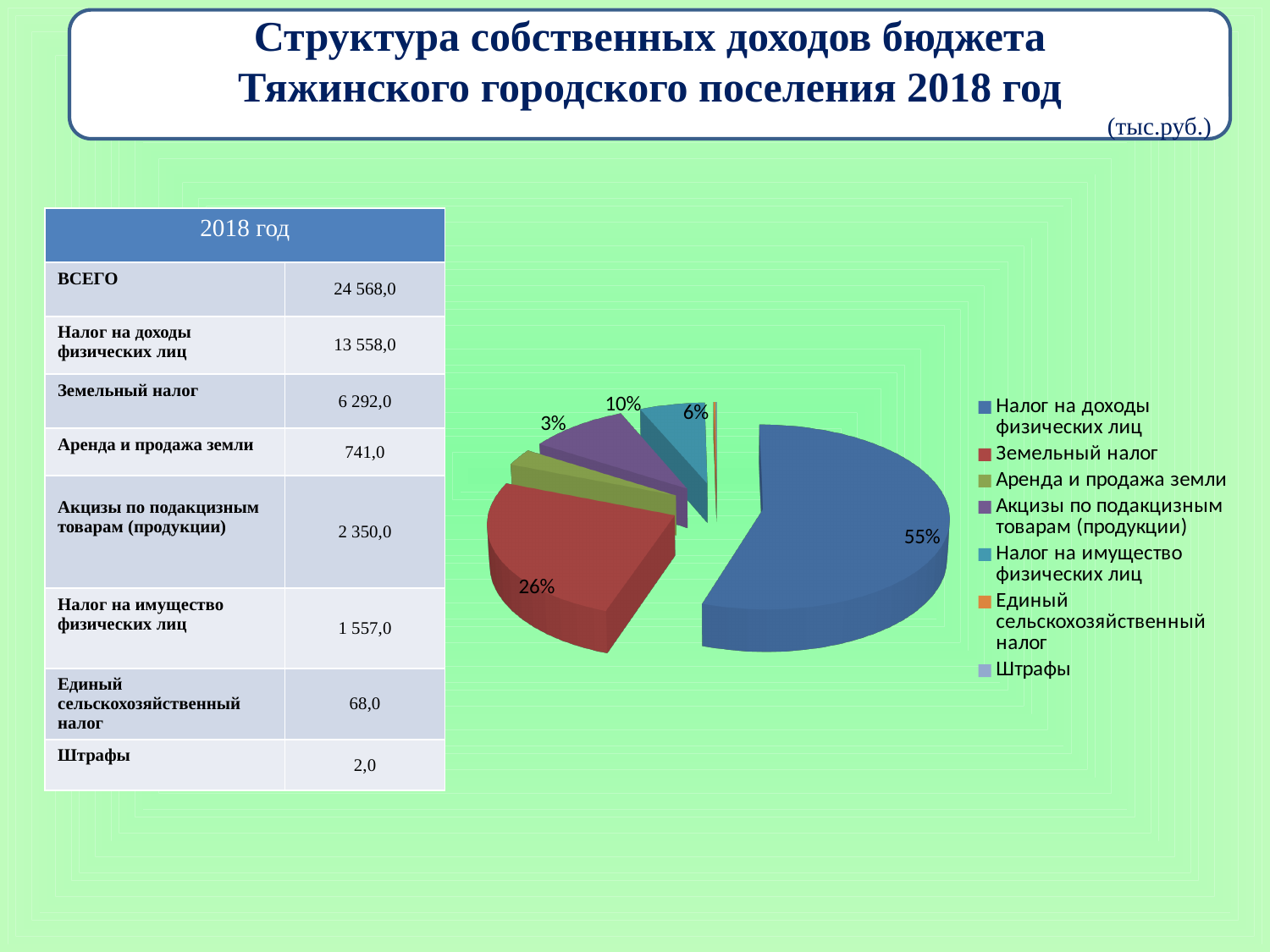
What share of the pie does "Налог на доходы физических лиц" take? 55% By how many percentage points does the "Налог на доходы физических лиц" slice exceed the "Земельный налог" slice? 29 What percentage is shown for "Налог на имущество физических лиц" in the pie chart? 6% Which legend entry is shown in orange? Единый сельскохозяйственный налог Which category has the largest slice of the pie chart? Налог на доходы физических лиц Which slice is larger: "Земельный налог" or "Акцизы по подакцизным товарам (продукции)"? Земельный налог What kind of chart is shown on the slide? pie chart How many categories does the legend of the pie chart list? 7 What percentage is shown for "Аренда и продажа земли" in the pie chart? 3% What percentage is shown for "Земельный налог" in the pie chart? 26% What percentage is shown for "Акцизы по подакцизным товарам (продукции)" in the pie chart? 10% What colour is the "Земельный налог" slice in the pie chart? red